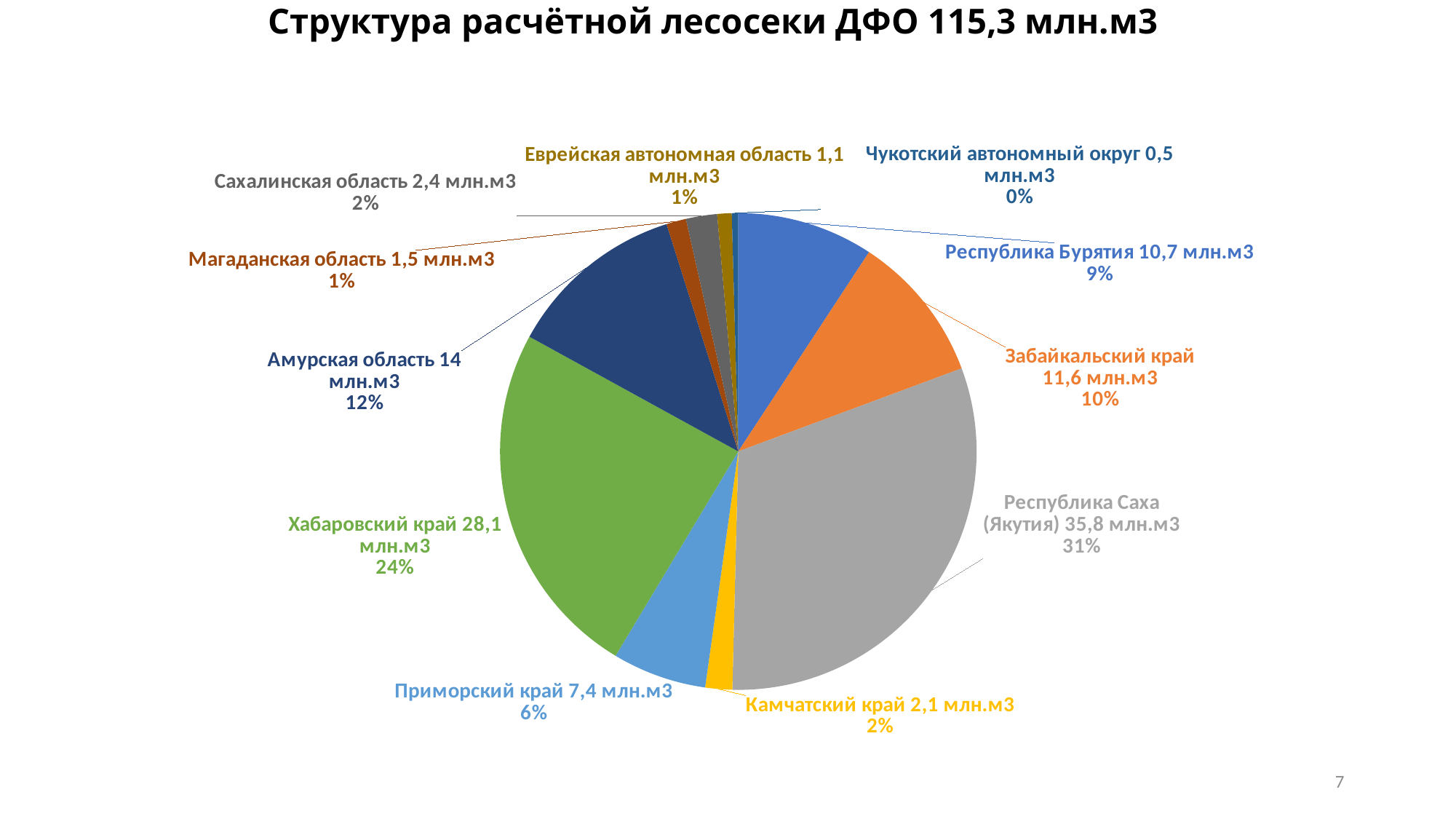
Which region has the largest slice of the pie? Республика Саха (Якутия) What is the difference in млн.м3 between Республика Саха (Якутия) and Хабаровский край? 7,7 млн.м3 What is the value for Республика Саха (Якутия)? 35,8 млн.м3 Which region has the smallest slice of the pie? Чукотский автономный округ What is the value for Амурская область? 14 млн.м3 What type of chart is shown on the slide? pie chart Which is larger, Забайкальский край or Республика Бурятия? Забайкальский край What is the value for Сахалинская область? 2,4 млн.м3 What share of the pie does Приморский край have? 6% How many slices does the pie chart have? 11 What share of the pie does Хабаровский край have? 24% What is the title of the chart? Структура расчётной лесосеки ДФО 115,3 млн.м3